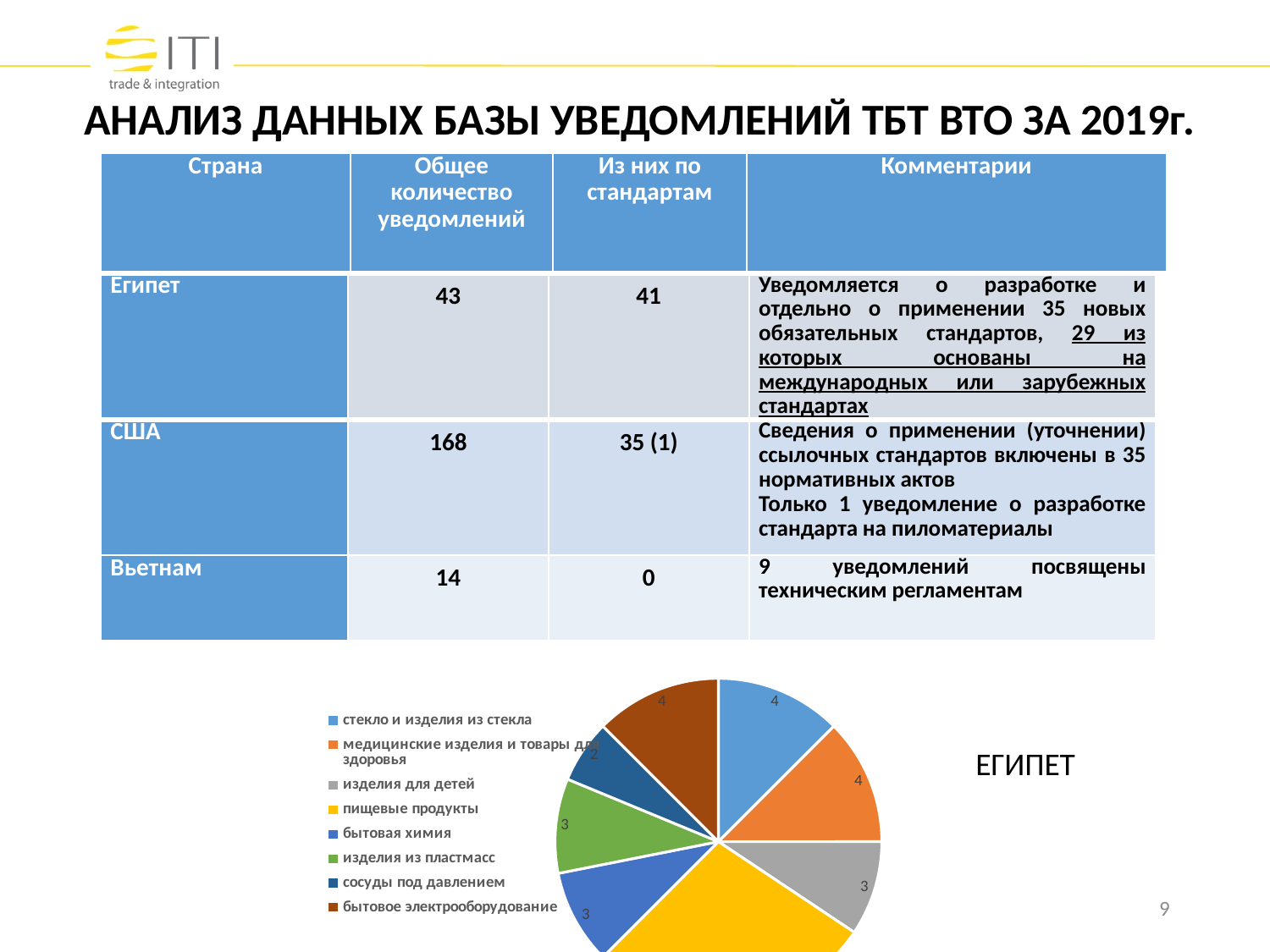
How many categories does the legend of the pie chart list? 8 What is the value for "изделия из пластмасс" in the pie chart? 3 What colour is the slice for "пищевые продукты" in the pie chart? yellow Which category has the smallest slice in the pie chart? сосуды под давлением What kind of chart is shown on the slide? pie chart What is the value for "изделия для детей" in the pie chart? 3 What is the value for "бытовое электрооборудование" in the pie chart? 4 Which is larger in the pie chart: "медицинские изделия и товары для здоровья" or "сосуды под давлением"? медицинские изделия и товары для здоровья What is the value for "сосуды под давлением" in the pie chart? 2 What country name is written next to the pie chart? ЕГИПЕТ What is the difference between the values for "стекло и изделия из стекла" and "сосуды под давлением" in the pie chart? 2 What is the value for "стекло и изделия из стекла" in the pie chart? 4